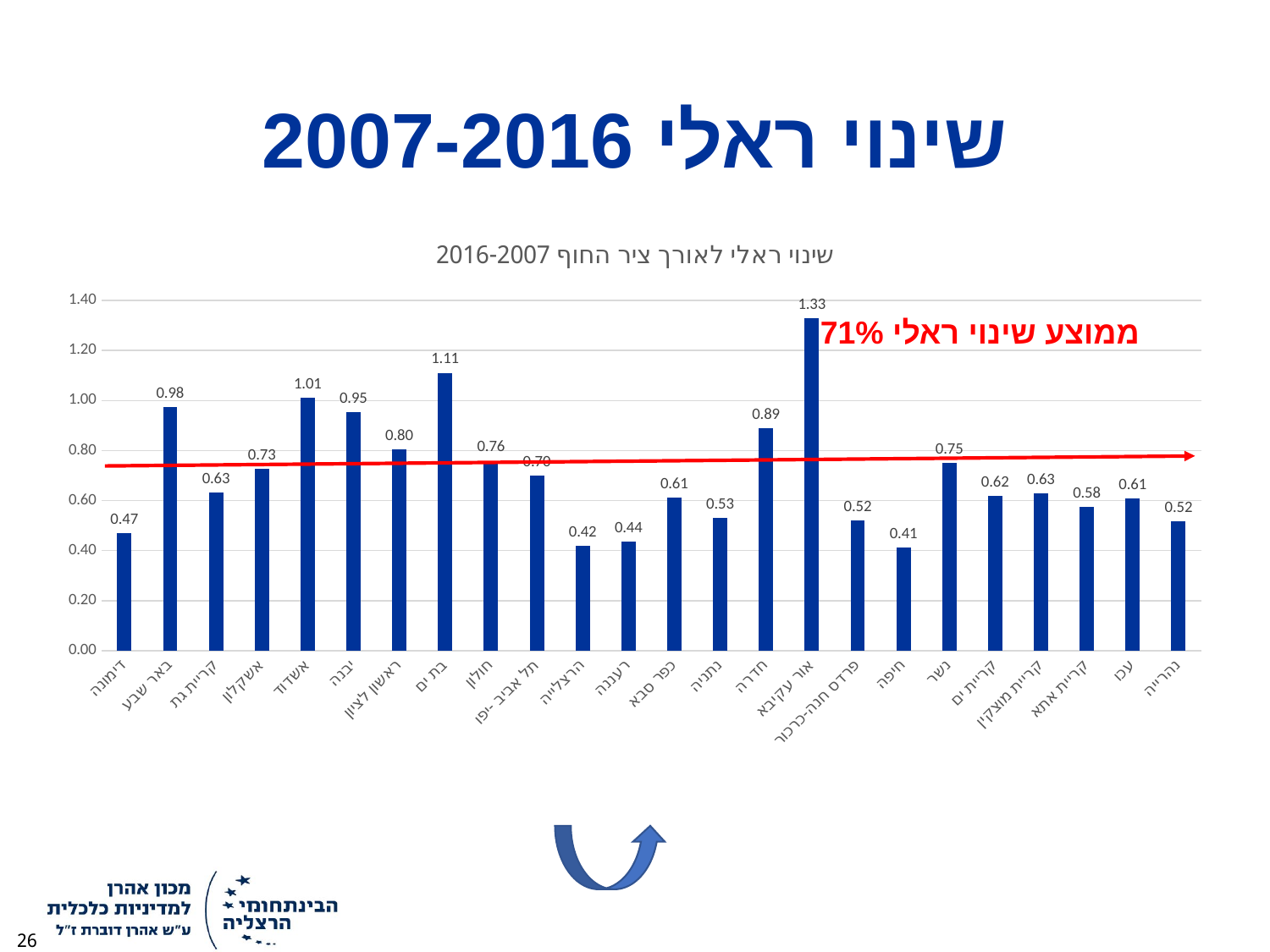
What is the value for בת ים? 1.11 What is the value for חיפה? 0.41 What average real change does the red annotation on the chart state? 71% What is the difference between the values for אור עקיבא and חיפה? 0.92 Which city has the lowest value in the chart? חיפה What is the title of the chart? שינוי ראלי לאורך ציר החוף 2016-2007 What is the value for באר שבע? 0.98 Which city has the highest value in the chart? אור עקיבא What is the value for אור עקיבא? 1.33 What type of chart is shown on the slide? bar chart Which is larger, the value for אשדוד or the value for יבנה? אשדוד How many cities are shown on the x axis of the chart? 24